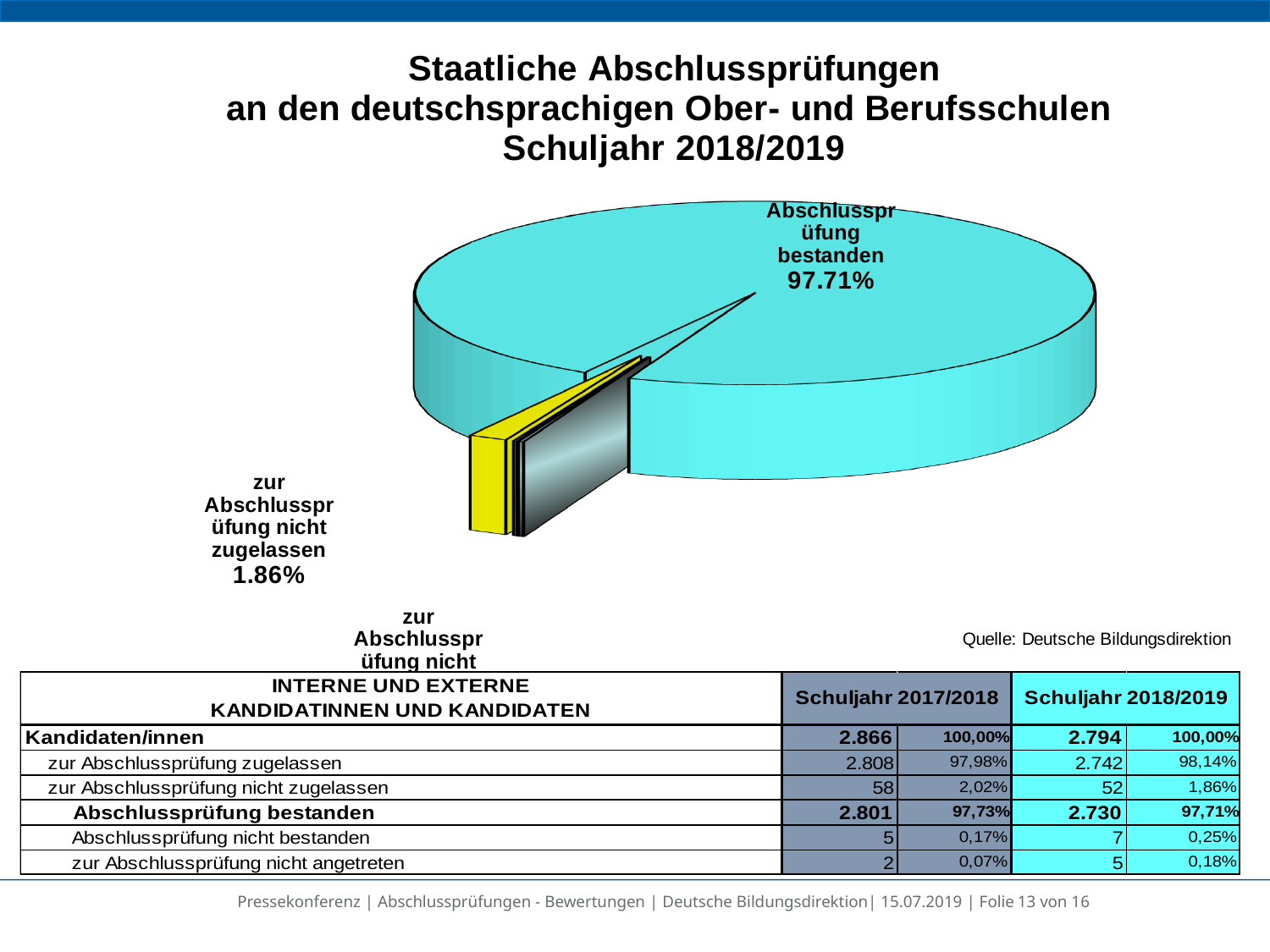
What share of the pie does "Abschlussprüfung bestanden" represent? 97.71% Which school year does the pie chart on the slide refer to? Schuljahr 2018/2019 What is the difference in percentage points between the "Abschlussprüfung bestanden" slice and the "zur Abschlussprüfung nicht zugelassen" slice? 95.85% What share of the pie does "zur Abschlussprüfung nicht zugelassen" represent? 1.86% Which is larger in the pie chart: "Abschlussprüfung bestanden" or "zur Abschlussprüfung nicht zugelassen"? Abschlussprüfung bestanden What kind of chart is shown on the slide? pie chart What colour is the "zur Abschlussprüfung nicht zugelassen" slice in the pie chart? yellow Which labelled slice of the pie chart is the largest? Abschlussprüfung bestanden